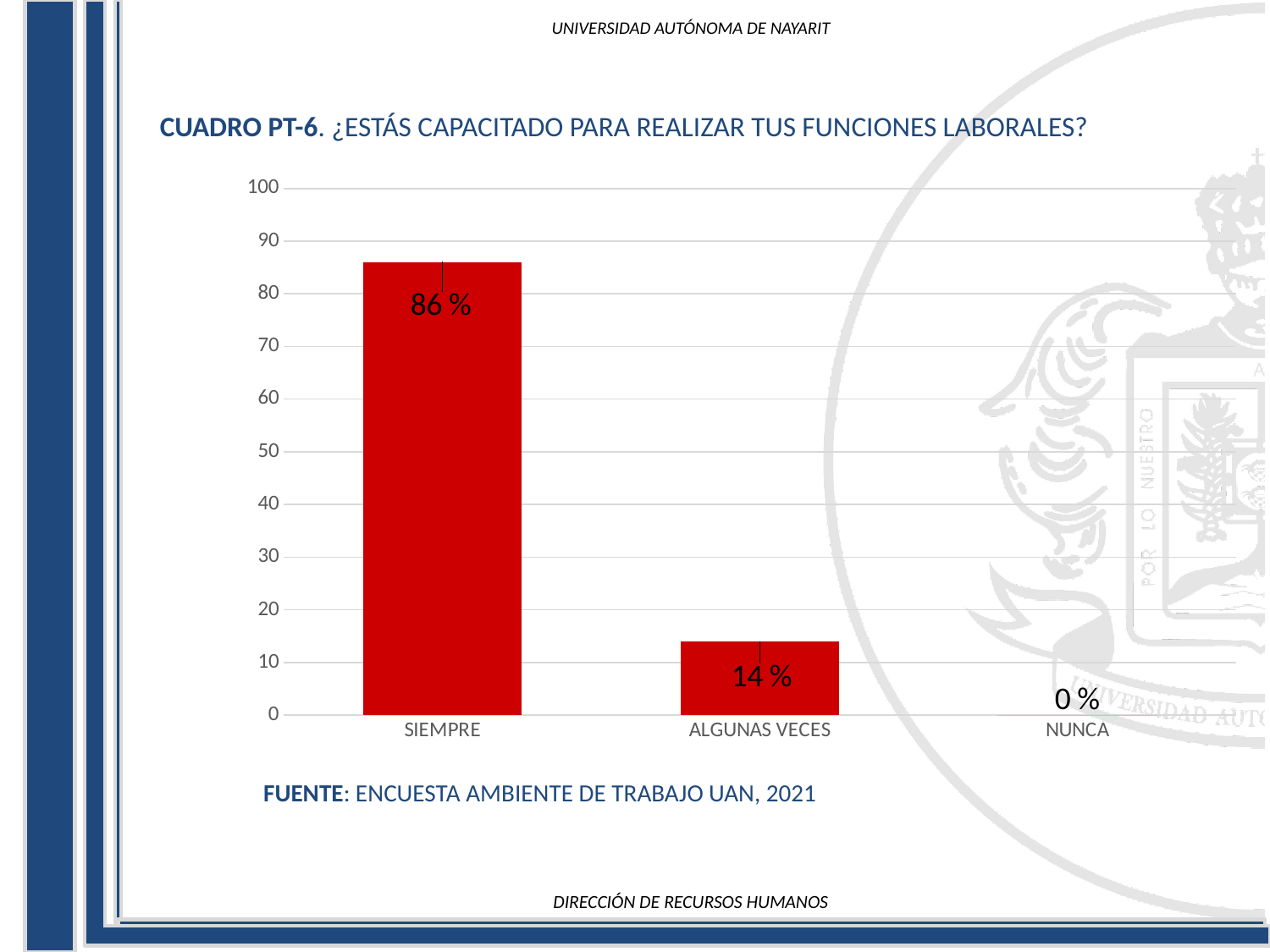
What is the value for NUNCA? 0 % Is the value for SIEMPRE greater or less than 80? greater Which category has the lowest value? NUNCA What is the title of the chart? CUADRO PT-6. ¿ESTÁS CAPACITADO PARA REALIZAR TUS FUNCIONES LABORALES? Which category has the highest value? SIEMPRE What is the value for ALGUNAS VECES? 14 % What is the difference between the values for SIEMPRE and ALGUNAS VECES? 72 % How many categories are shown on the x axis? 3 Is the value for ALGUNAS VECES greater or less than 20? less What kind of chart is shown on the slide? bar chart What is the value for SIEMPRE? 86 % Which is larger, the value for ALGUNAS VECES or the value for NUNCA? ALGUNAS VECES